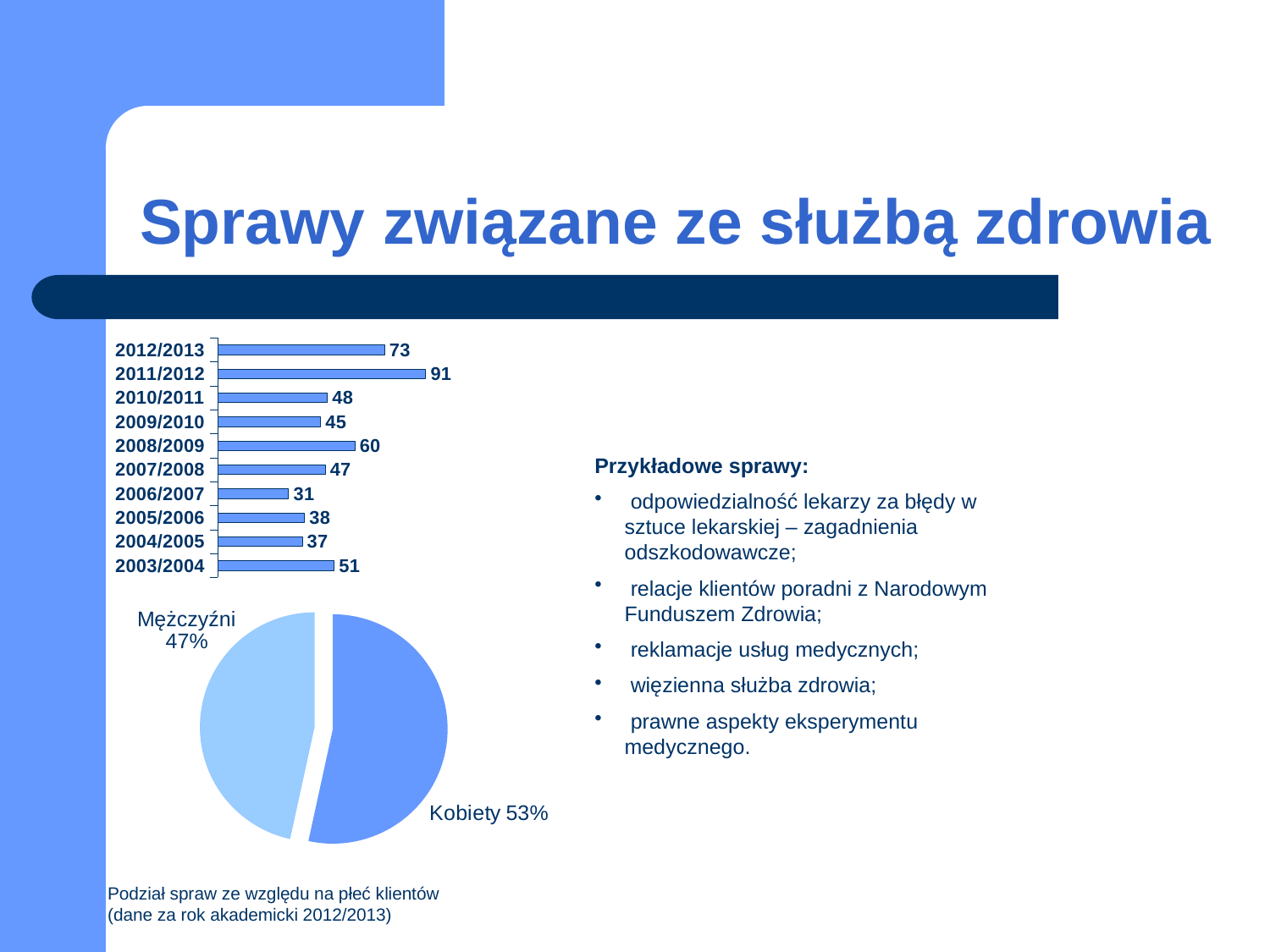
In the bar chart at the top left, what is the difference between the values for 2011/2012 and 2012/2013? 18 In the pie chart at the bottom left, which slice is larger, Kobiety or Mężczyźni? Kobiety In the pie chart at the bottom left, what share is labelled Mężczyźni? 47% How many academic years are shown in the bar chart at the top left? 10 In the bar chart at the top left, what is the value for 2003/2004? 51 In the bar chart at the top left, which academic year has the highest value? 2011/2012 What kind of chart is the chart at the bottom left of the slide? Pie chart In the bar chart at the top left, which is larger, the value for 2008/2009 or the value for 2009/2010? 2008/2009 In the pie chart at the bottom left, what share is labelled Kobiety? 53% In the bar chart at the top left, which academic year has the lowest value? 2006/2007 In the bar chart at the top left, what is the value for 2011/2012? 91 What kind of chart is the chart at the top left of the slide? Bar chart